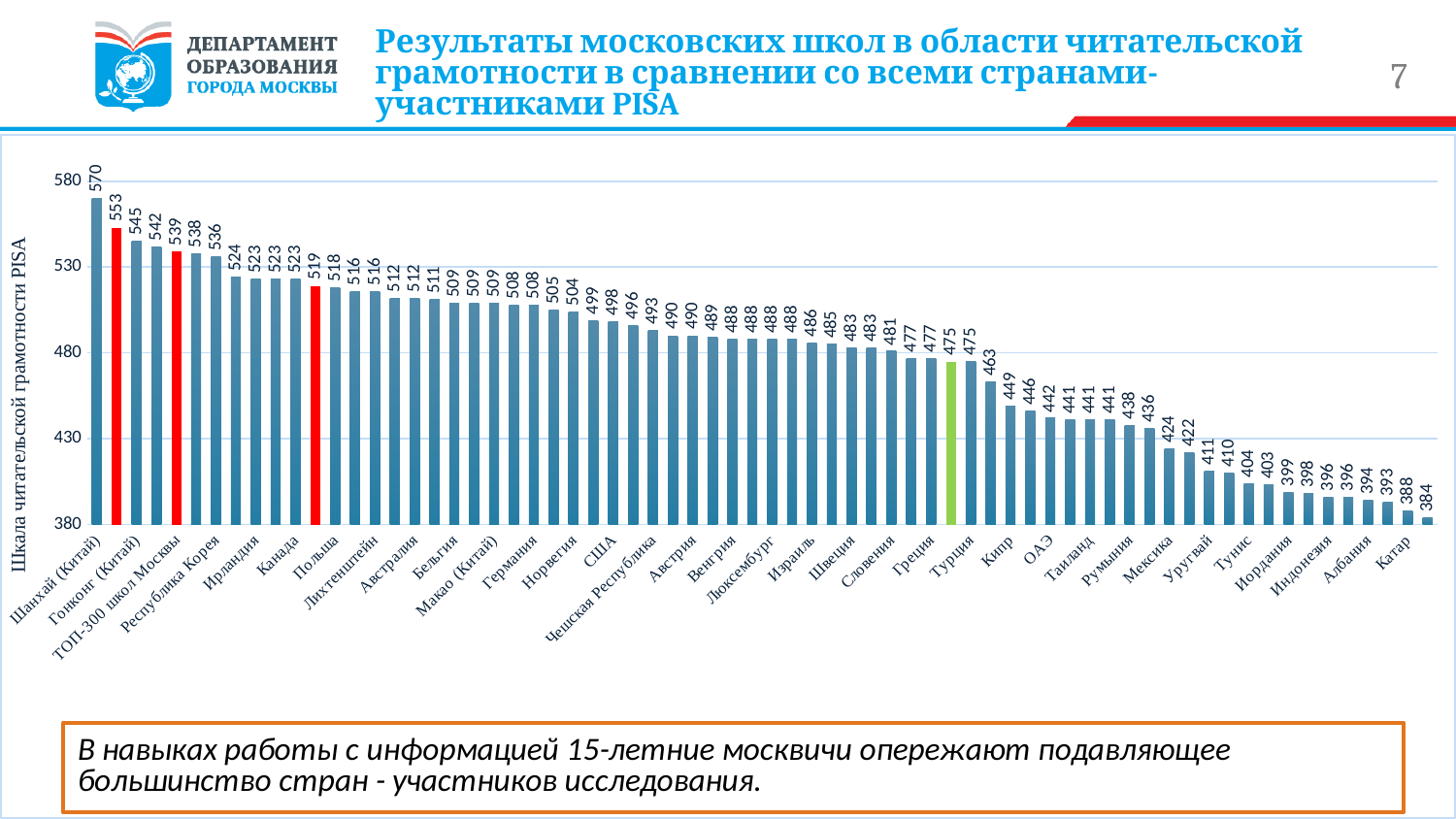
What is the value for Германия? 508 What is the value for Кипр? 449 What is the title of the vertical axis? Шкала читательской грамотности PISA Which has a larger value, Канада or Австралия? Канада Which category has the highest value on the chart? Шанхай (Китай) What is the value for Катар? 388 What is the value for Гонконг (Китай)? 545 What is the value for Польша? 518 What is the difference between the values for Шанхай (Китай) and Гонконг (Китай)? 25 What kind of chart is shown on the slide? Bar chart What is the value for Шанхай (Китай)? 570 Do the values rise or fall from left to right along the x axis? Fall